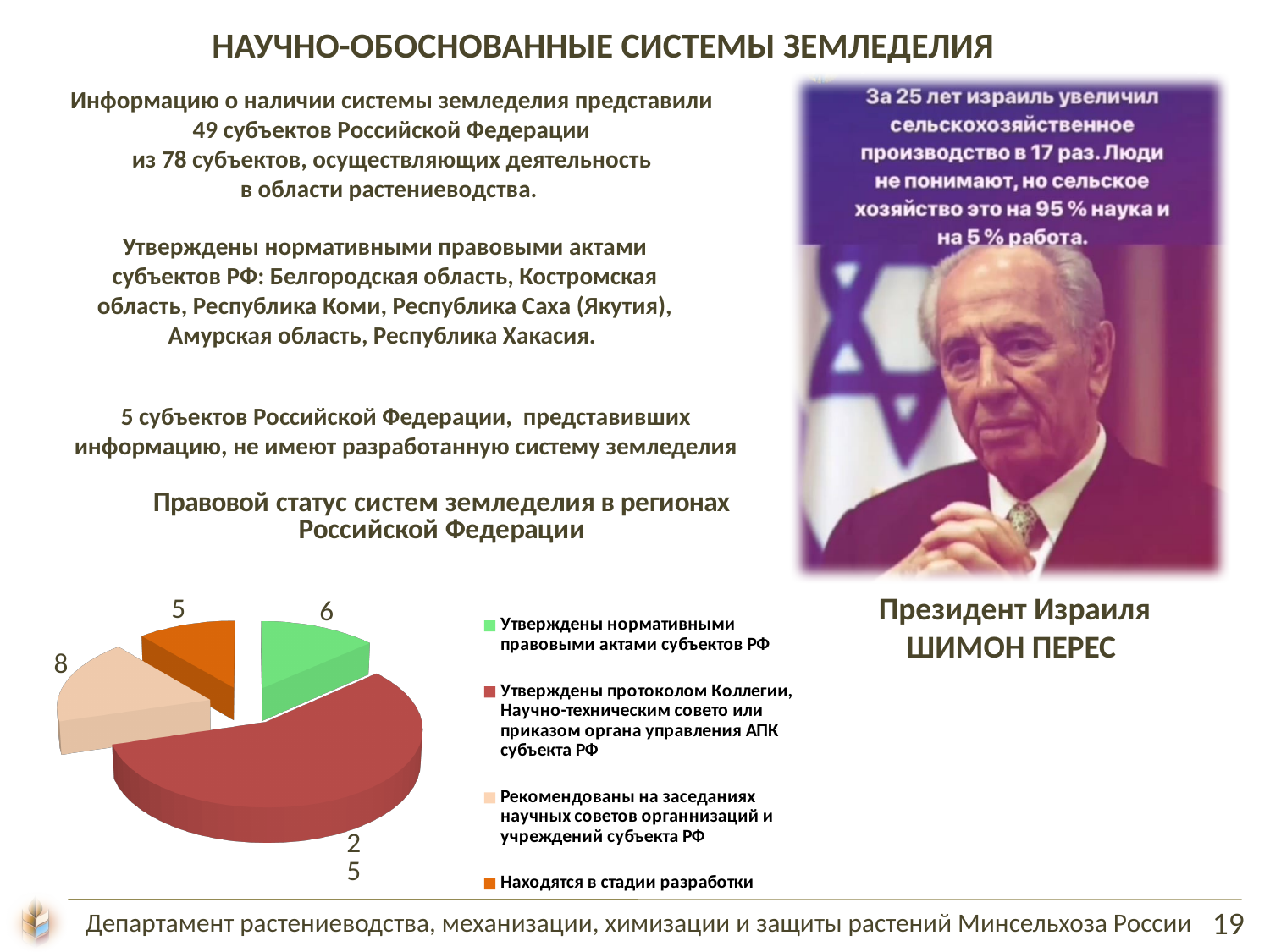
In the pie chart, what is the value for "Находятся в стадии разработки"? 5 How many slices does the pie chart "Правовой статус систем земледелия в регионах Российской Федерации" have? 4 In the pie chart, which is larger: the value for "Утверждены нормативными правовыми актами субъектов РФ" or the value for "Рекомендованы на заседаниях научных советов органнизаций и учреждений субъекта РФ"? Рекомендованы на заседаниях научных советов органнизаций и учреждений субъекта РФ What colour is the slice for "Находятся в стадии разработки" in the pie chart? orange How many entries does the legend of the pie chart list? 4 What kind of chart is shown under the title "Правовой статус систем земледелия в регионах Российской Федерации"? pie chart Which category has the smallest slice in the pie chart? Находятся в стадии разработки Which category has the largest slice in the pie chart? Утверждены протоколом Коллегии, Научно-техническим совето или приказом органа управления АПК субъекта РФ In the pie chart, what is the difference between the value for "Рекомендованы на заседаниях научных советов органнизаций и учреждений субъекта РФ" and the value for "Находятся в стадии разработки"? 3 In the pie chart, what is the value for "Утверждены нормативными правовыми актами субъектов РФ"? 6 In the pie chart, what is the value for "Утверждены протоколом Коллегии, Научно-техническим совето или приказом органа управления АПК субъекта РФ"? 25 In the pie chart, what is the value for "Рекомендованы на заседаниях научных советов органнизаций и учреждений субъекта РФ"? 8